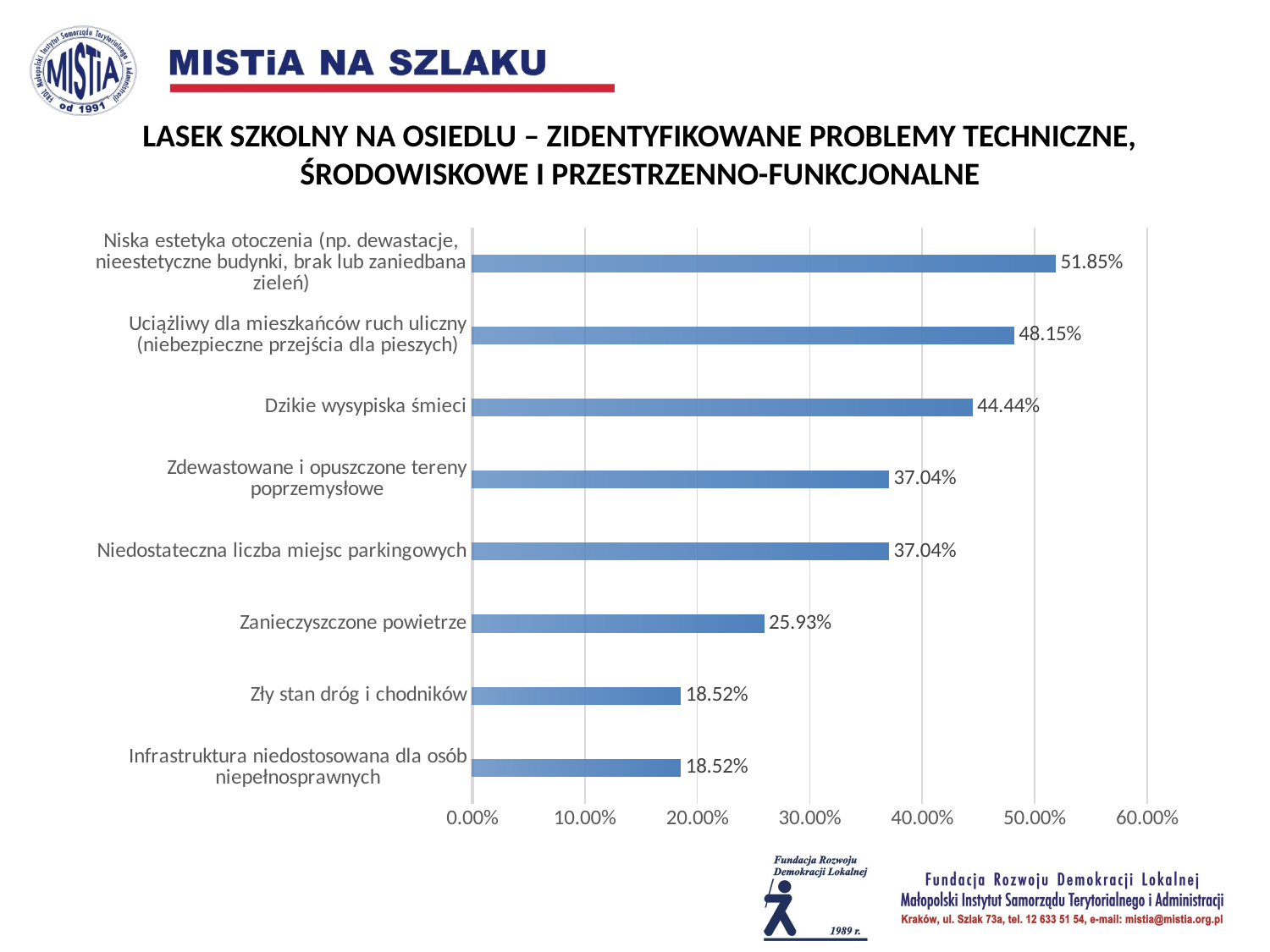
How many categories are shown in the chart? 8 Which is larger: the value for "Zdewastowane i opuszczone tereny poprzemysłowe" or the value for "Zanieczyszczone powietrze"? Zdewastowane i opuszczone tereny poprzemysłowe What is the difference between the values for "Zanieczyszczone powietrze" and "Zły stan dróg i chodników"? 7.41% What is the value for "Zanieczyszczone powietrze"? 25.93% Is the value for "Zły stan dróg i chodników" greater or less than 20.00%? less What is the difference between the values for "Niska estetyka otoczenia" and "Dzikie wysypiska śmieci"? 7.41% Is the value for "Dzikie wysypiska śmieci" greater or less than 40.00%? greater Which category has the highest value? Niska estetyka otoczenia (np. dewastacje, nieestetyczne budynki, brak lub zaniedbana zieleń) What is the value for "Dzikie wysypiska śmieci"? 44.44% What is the maximum value shown on the horizontal axis? 60.00% What kind of chart is shown on the slide? Bar chart What is the value for "Uciążliwy dla mieszkańców ruch uliczny (niebezpieczne przejścia dla pieszych)"? 48.15%